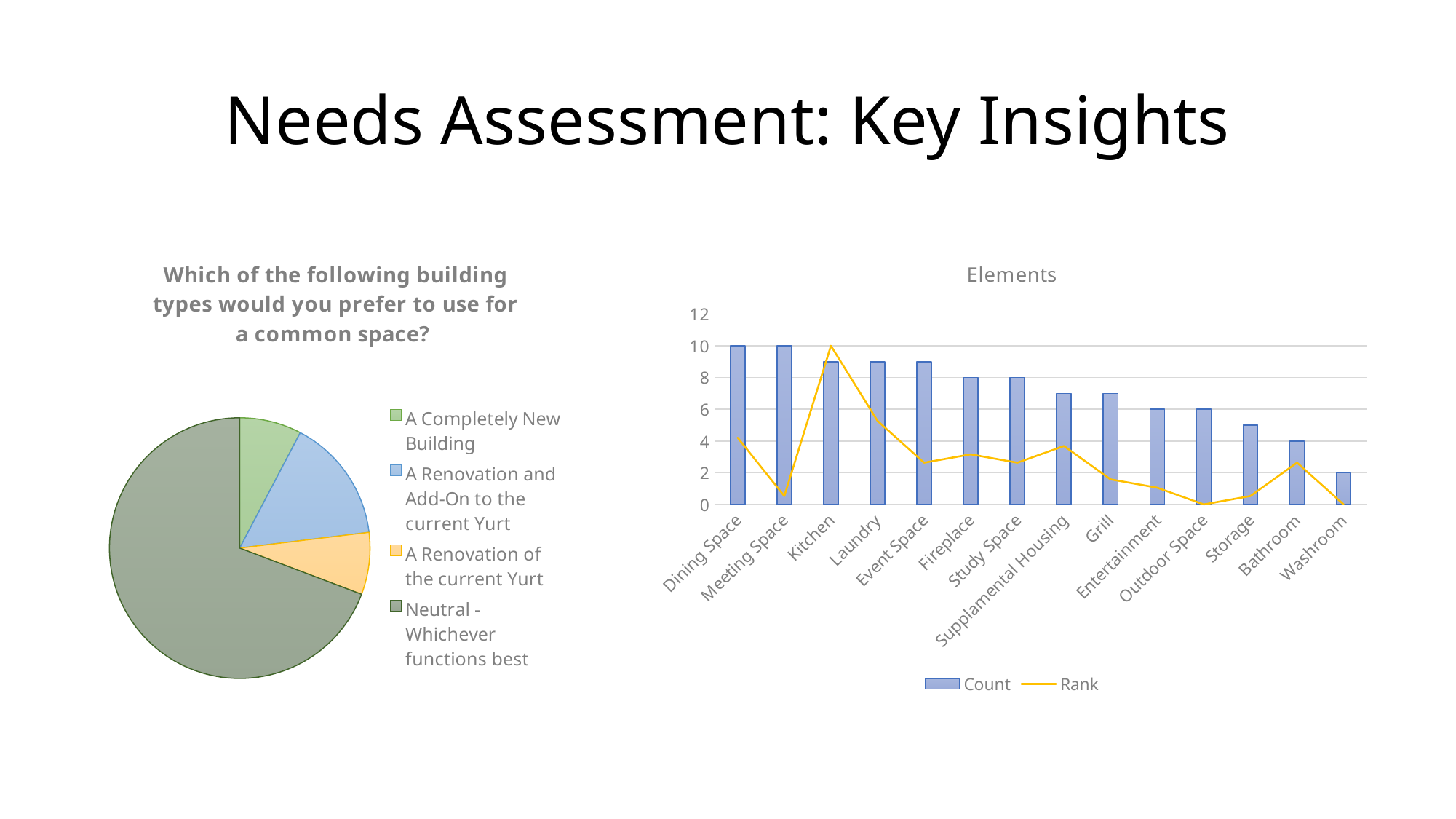
In the Elements chart, which category has the lowest Count? Washroom In the Elements chart, what is the Count value for Fireplace? 8 In the Elements chart, which is larger, the Count for Entertainment or the Count for Bathroom? Entertainment In the Elements chart, what is the Count value for Washroom? 2 In the Elements chart, what is the Count value for Bathroom? 4 In the Elements chart, how many series does the legend list? 2 In the Elements chart, what is the Count value for Dining Space? 10 In the Elements chart, do the Count values generally rise or fall from left to right? fall In the Elements chart, is the Count for Kitchen greater or less than 8? greater In the pie chart on the left, which building type has the largest slice? Neutral - Whichever functions best In the Elements chart, what is the difference between the Count for Dining Space and the Count for Washroom? 8 In the Elements chart, is the Count for Storage greater or less than 6? less